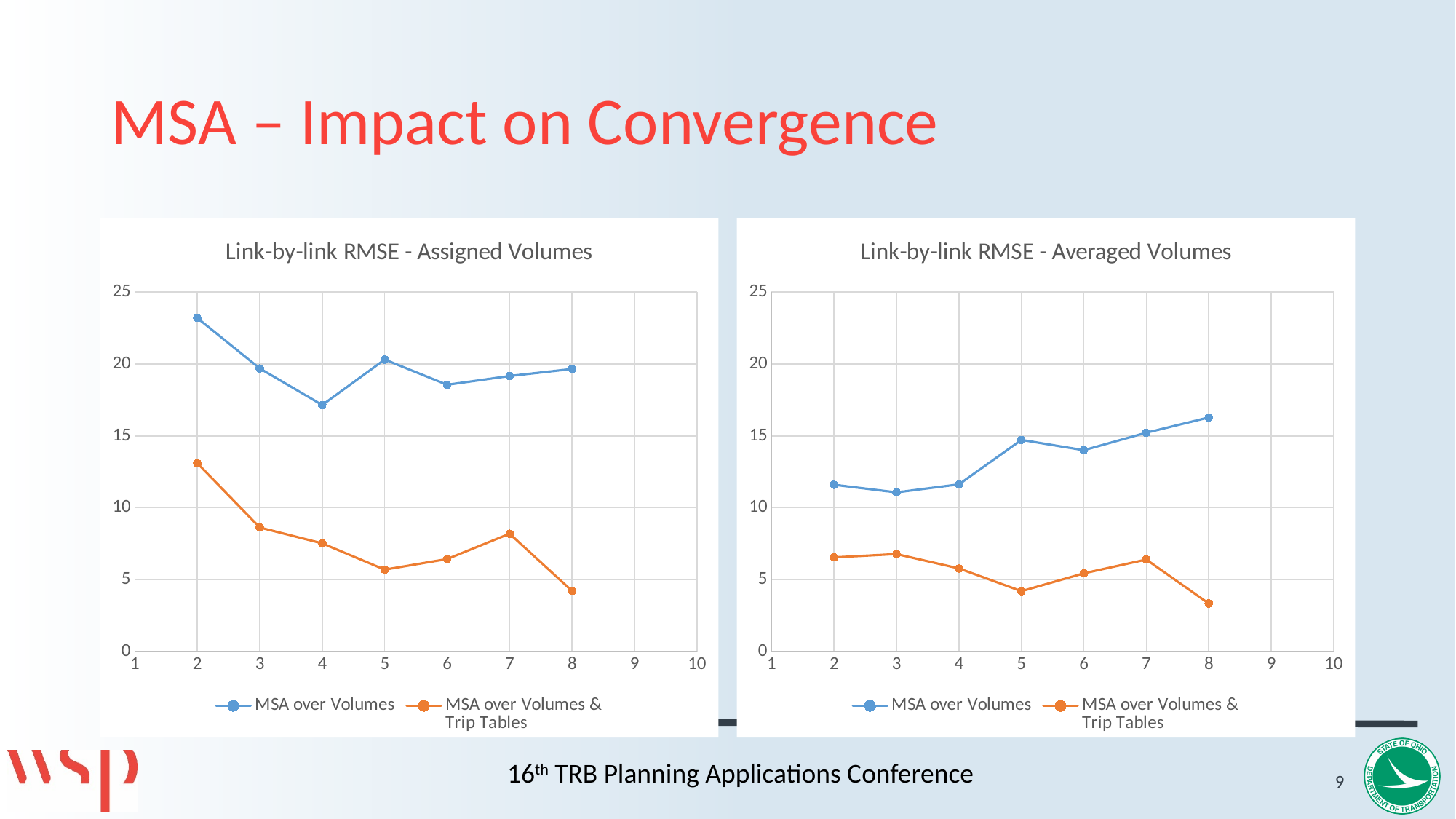
In the 'Link-by-link RMSE - Assigned Volumes' chart, at which x value is the 'MSA over Volumes & Trip Tables' series lowest? 8 What kind of chart is the 'Link-by-link RMSE - Assigned Volumes' chart? line chart In the 'Link-by-link RMSE - Averaged Volumes' chart, at which x value is the 'MSA over Volumes' series highest? 8 In the 'Link-by-link RMSE - Assigned Volumes' chart, is the value of 'MSA over Volumes' at x = 4 greater or less than 20? less In the 'Link-by-link RMSE - Averaged Volumes' chart, is the value of 'MSA over Volumes' at x = 3 greater or less than 15? less In the 'Link-by-link RMSE - Assigned Volumes' chart, how many data points does the 'MSA over Volumes' series have? 7 Which colour is used for the 'MSA over Volumes & Trip Tables' series in the 'Link-by-link RMSE - Assigned Volumes' chart? orange In the 'Link-by-link RMSE - Assigned Volumes' chart, is the value of 'MSA over Volumes & Trip Tables' at x = 2 greater or less than 10? greater In the 'Link-by-link RMSE - Averaged Volumes' chart, which series has the larger value at x = 5, 'MSA over Volumes' or 'MSA over Volumes & Trip Tables'? MSA over Volumes How many series does the legend of the 'Link-by-link RMSE - Averaged Volumes' chart list? 2 In the 'Link-by-link RMSE - Assigned Volumes' chart, at which x value is the 'MSA over Volumes' series highest? 2 In the 'Link-by-link RMSE - Averaged Volumes' chart, does the 'MSA over Volumes' series generally rise or fall from x = 2 to x = 8? rise